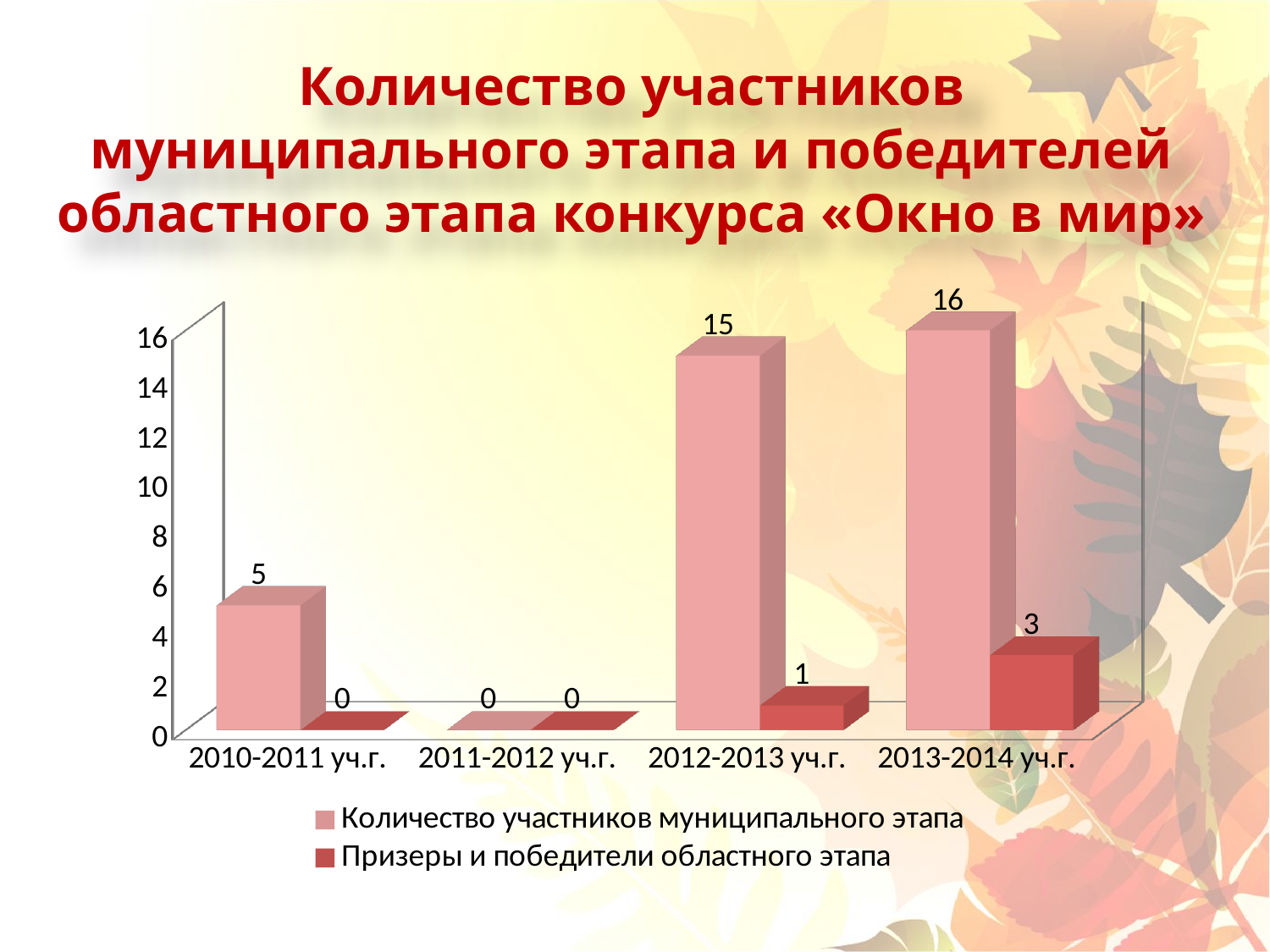
How many series does the legend list? 2 What kind of chart is shown on the slide? Bar chart What is the value for 'Количество участников муниципального этапа' in 2010-2011 уч.г.? 5 How many years are shown on the x axis? 4 Which is larger: 'Призеры и победители областного этапа' in 2012-2013 уч.г. or in 2013-2014 уч.г.? 2013-2014 уч.г. Which year has the highest value for 'Количество участников муниципального этапа'? 2013-2014 уч.г. What is the difference between 'Количество участников муниципального этапа' in 2013-2014 уч.г. and in 2010-2011 уч.г.? 11 What is the value for 'Призеры и победители областного этапа' in 2013-2014 уч.г.? 3 Does 'Количество участников муниципального этапа' rise or fall from 2011-2012 уч.г. to 2013-2014 уч.г.? Rise Which year has the lowest value for 'Количество участников муниципального этапа'? 2011-2012 уч.г. What is the value for 'Призеры и победители областного этапа' in 2012-2013 уч.г.? 1 What is the value for 'Количество участников муниципального этапа' in 2012-2013 уч.г.? 15